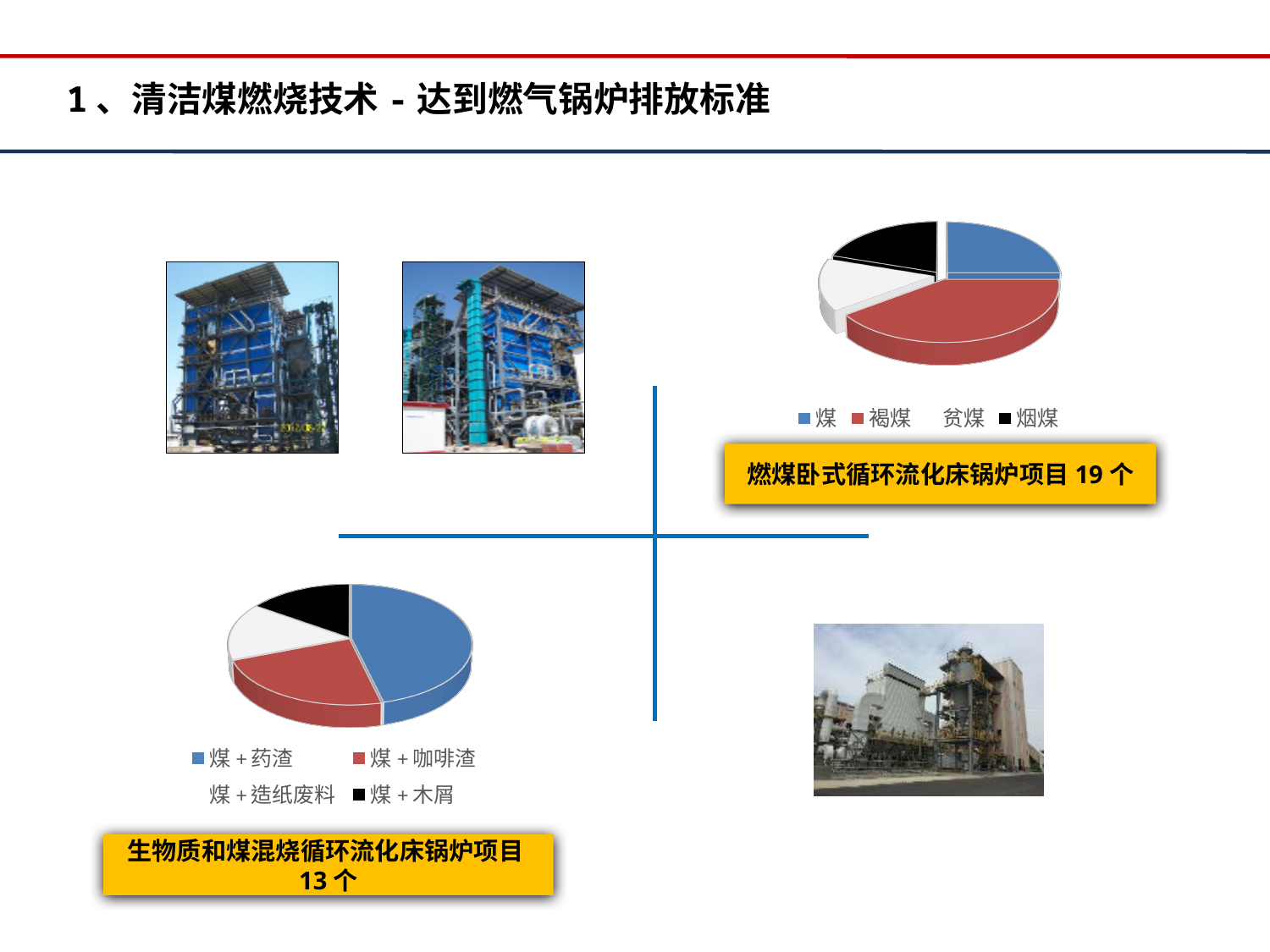
In the top-right pie chart, which slice is larger, 煤 or 褐煤? 褐煤 In the bottom-left pie chart, which slice is larger, 煤＋药渣 or 煤＋造纸废料? 煤＋药渣 In the bottom-left pie chart, which category has the largest slice? 煤＋药渣 In the bottom-left pie chart, how many categories does the legend list? 4 What kind of chart is shown in the bottom-left of the slide? pie chart In the top-right pie chart, how many categories does the legend list? 4 What kind of chart is shown in the top-right of the slide? pie chart In the top-right pie chart, which category has the largest slice? 褐煤 In the bottom-left pie chart, what colour is the slice for 煤＋咖啡渣? red In the top-right pie chart, what colour is the slice for 烟煤? black In the bottom-left pie chart, which slice is larger, 煤＋咖啡渣 or 煤＋木屑? 煤＋咖啡渣